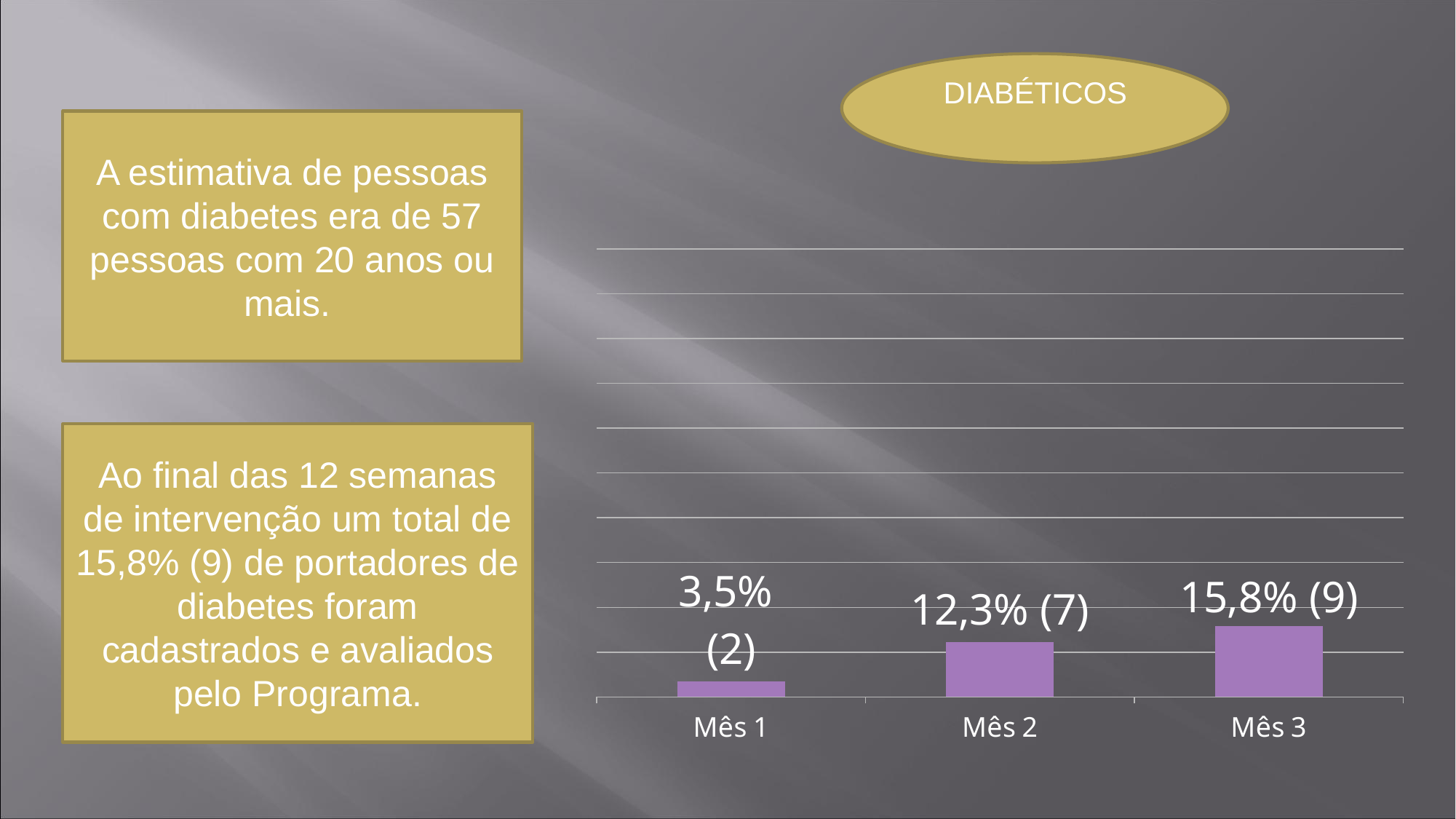
How many more people are counted in Mês 3 than in Mês 1? 7 Which month has the lowest bar? Mês 1 Do the values rise or fall from Mês 1 to Mês 3? Rise Which is larger, the value for Mês 2 or the value for Mês 3? Mês 3 What colour are the bars in the chart? Purple What kind of chart is shown on the slide? Bar chart What is the data label shown for Mês 2? 12,3% (7) How many months (categories) are shown on the x axis? 3 What is the data label shown for Mês 1? 3,5% (2) Which month has the highest bar? Mês 3 What is the data label shown for Mês 3? 15,8% (9) What is the difference in percentage between Mês 2 and Mês 1? 8,8%